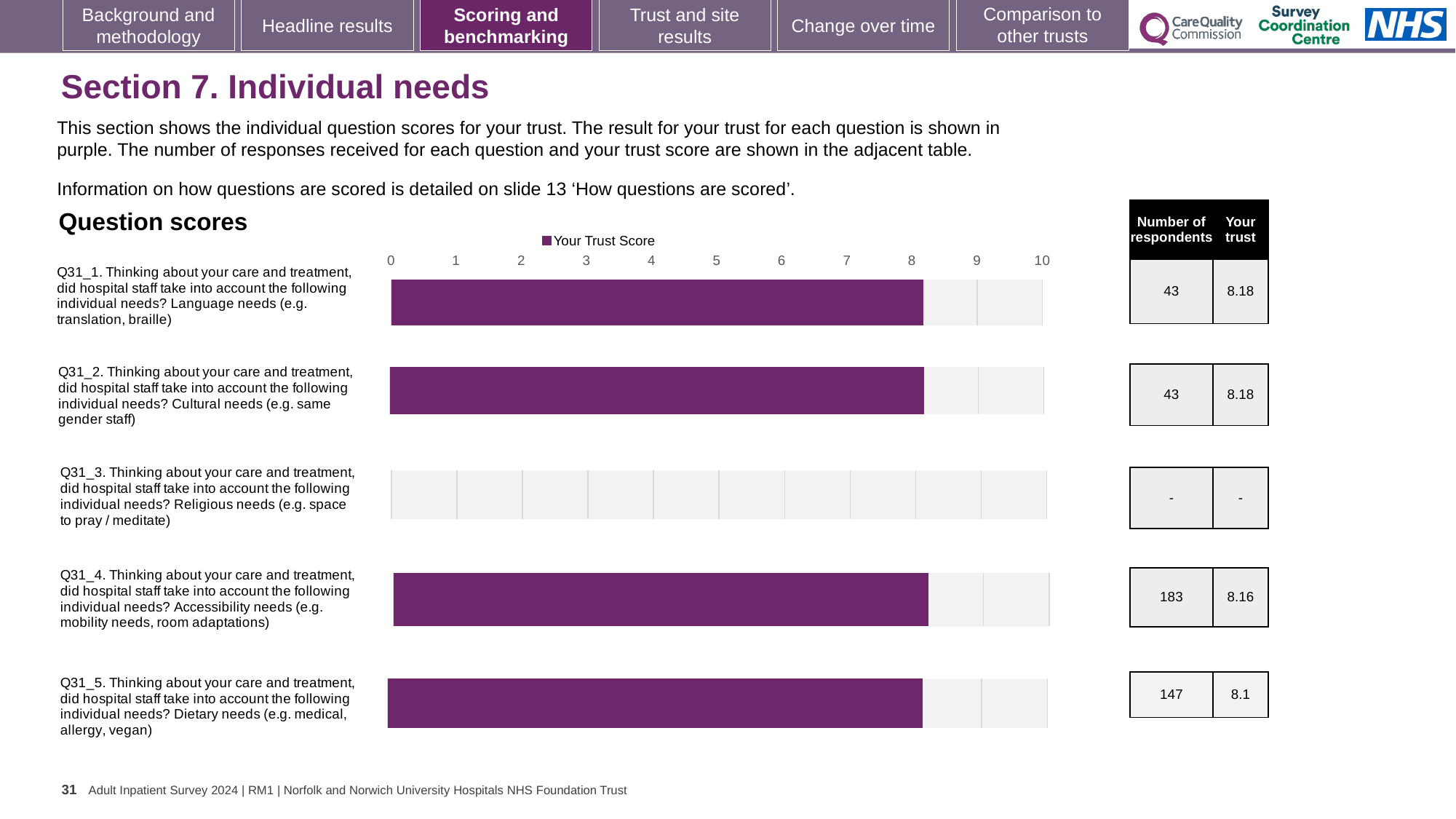
Which has more respondents, Q31_4 or Q31_5? Q31_4 What is the difference between the trust scores for Q31_1 and Q31_5? 0.08 How many questions are listed in the Question scores chart? 5 How many more respondents answered Q31_4 than Q31_5? 36 Is the trust score for Q31_1 greater or less than 8? greater What type of chart is used to show the question scores? Bar chart How many respondents answered Q31_2 (Cultural needs)? 43 What is the trust score for Q31_4 (Accessibility needs)? 8.16 Which question has the lowest trust score among those with a score shown? Q31_5 (Dietary needs) How many respondents answered Q31_4 (Accessibility needs)? 183 What is the trust score for Q31_5 (Dietary needs)? 8.1 What is the trust score for Q31_1 (Language needs)? 8.18